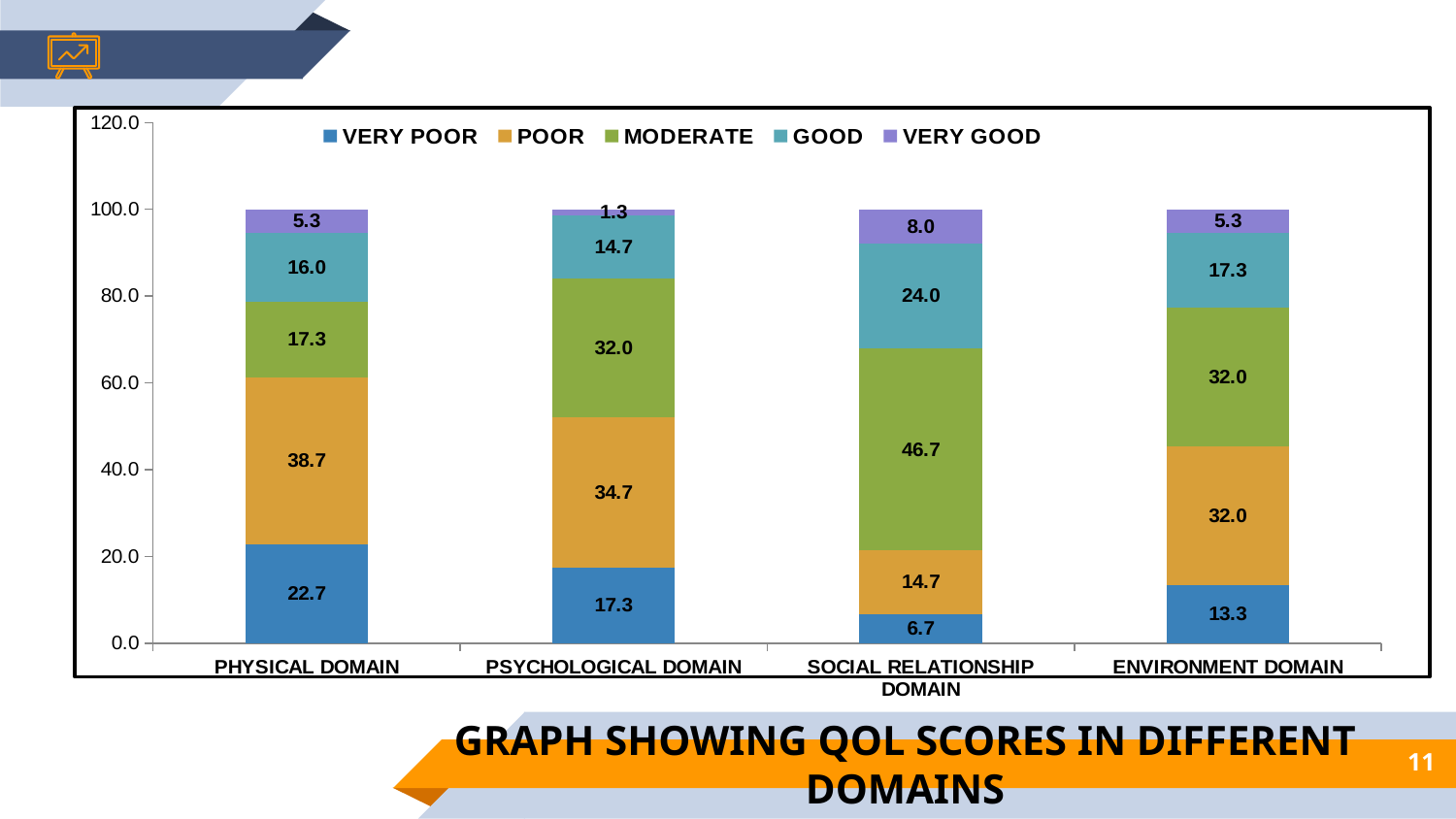
How many domains (categories) are shown on the x axis? 4 Which is larger: the GOOD value for the SOCIAL RELATIONSHIP DOMAIN or the GOOD value for the PHYSICAL DOMAIN? SOCIAL RELATIONSHIP DOMAIN Which domain has the lowest VERY POOR value? SOCIAL RELATIONSHIP DOMAIN What type of chart is shown on the slide? Stacked bar chart What is the MODERATE value for the SOCIAL RELATIONSHIP DOMAIN? 46.7 What is the GOOD value for the ENVIRONMENT DOMAIN? 17.3 What is the difference between the POOR values for the PHYSICAL DOMAIN and the PSYCHOLOGICAL DOMAIN? 4.0 What is the VERY POOR value for the PHYSICAL DOMAIN? 22.7 What is the VERY GOOD value for the PSYCHOLOGICAL DOMAIN? 1.3 How many series does the legend list? 5 What is the title shown below the chart? GRAPH SHOWING QOL SCORES IN DIFFERENT DOMAINS Which domain has the highest MODERATE value? SOCIAL RELATIONSHIP DOMAIN